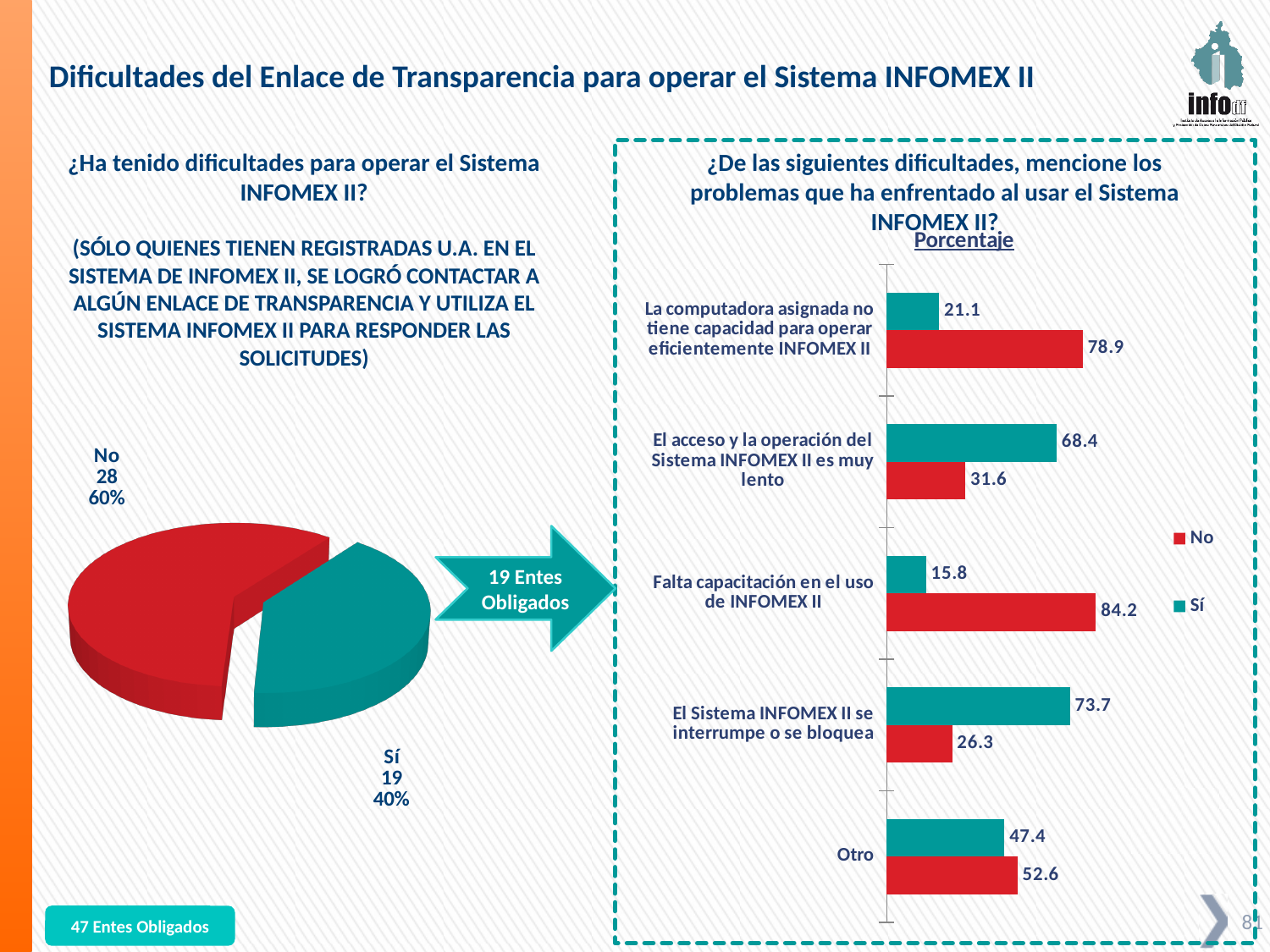
In the bar chart on the right, how many categories are shown? 5 In the pie chart on the left, what percentage of respondents answered "No"? 60% In the bar chart on the right, which colour represents the "Sí" series? Teal What kind of chart is the chart on the left side of the slide? Pie chart In the bar chart on the right, what is the "No" value for "El Sistema INFOMEX II se interrumpe o se bloquea"? 26.3 In the pie chart on the left, how many respondents answered "Sí"? 19 In the bar chart on the right, what is the difference between the "No" and "Sí" values for "La computadora asignada no tiene capacidad para operar eficientemente INFOMEX II"? 57.8 In the bar chart on the right, which category has the highest "Sí" value? El Sistema INFOMEX II se interrumpe o se bloquea In the bar chart on the right, what is the "Sí" value for "Falta capacitación en el uso de INFOMEX II"? 15.8 In the pie chart on the left, which answer has the larger slice, "No" or "Sí"? No In the bar chart on the right, which category has the lowest "Sí" value? Falta capacitación en el uso de INFOMEX II In the bar chart on the right, how many series does the legend list? 2